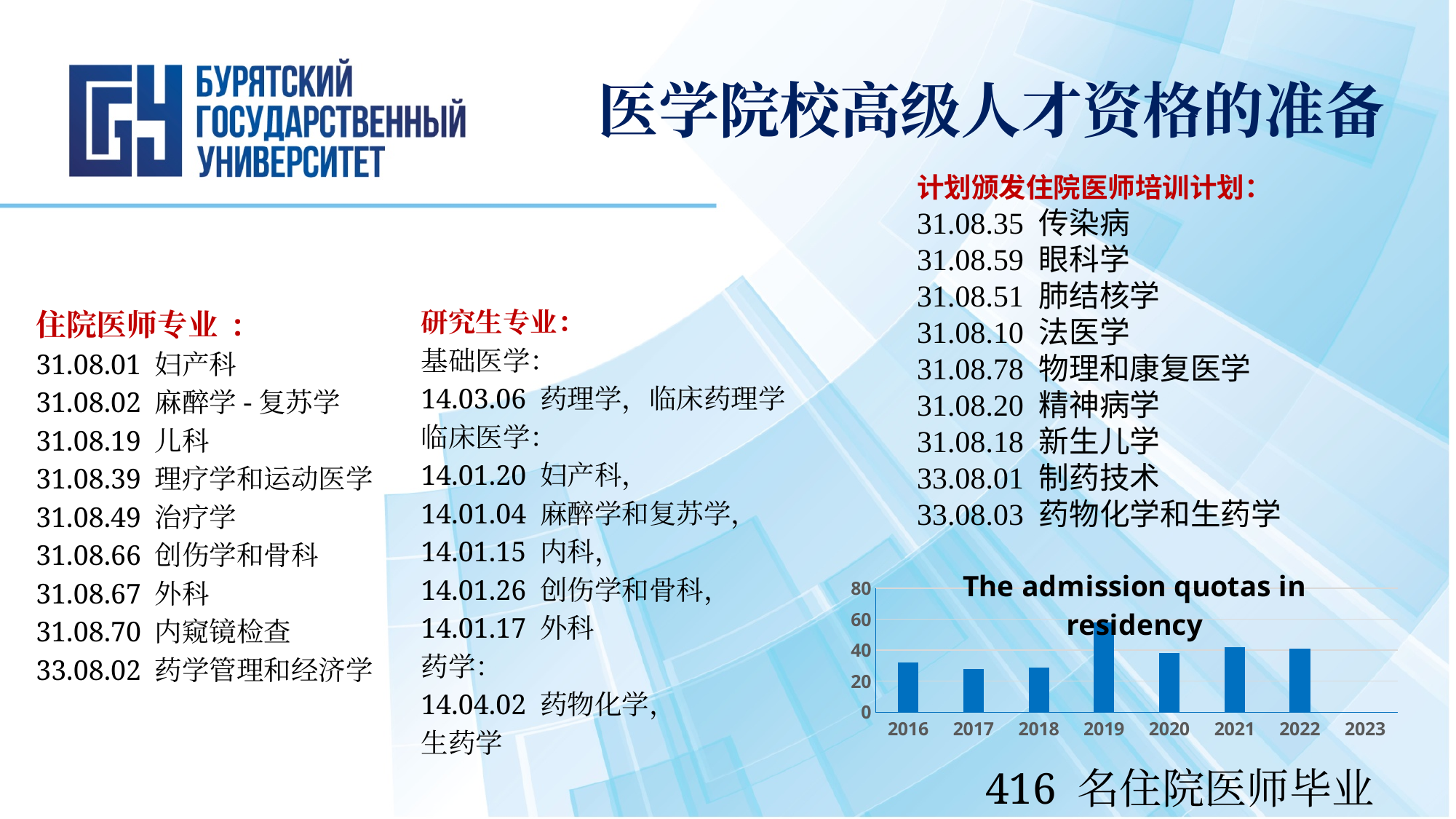
Which is larger, the value for 2021 or the value for 2018? 2021 What is the title of the chart on the slide? The admission quotas in residency Is the value for 2017 greater or less than 20? greater Which is larger, the value for 2019 or the value for 2016? 2019 Is the value for 2019 greater or less than 40? greater How many years are labelled on the x axis of the chart? 8 Is the value for 2016 greater or less than 40? less Which year has the highest admission quota in the chart? 2019 What kind of chart is shown on the slide? bar chart What is the highest tick value shown on the y axis of the chart? 80 Which is larger, the value for 2016 or the value for 2017? 2016